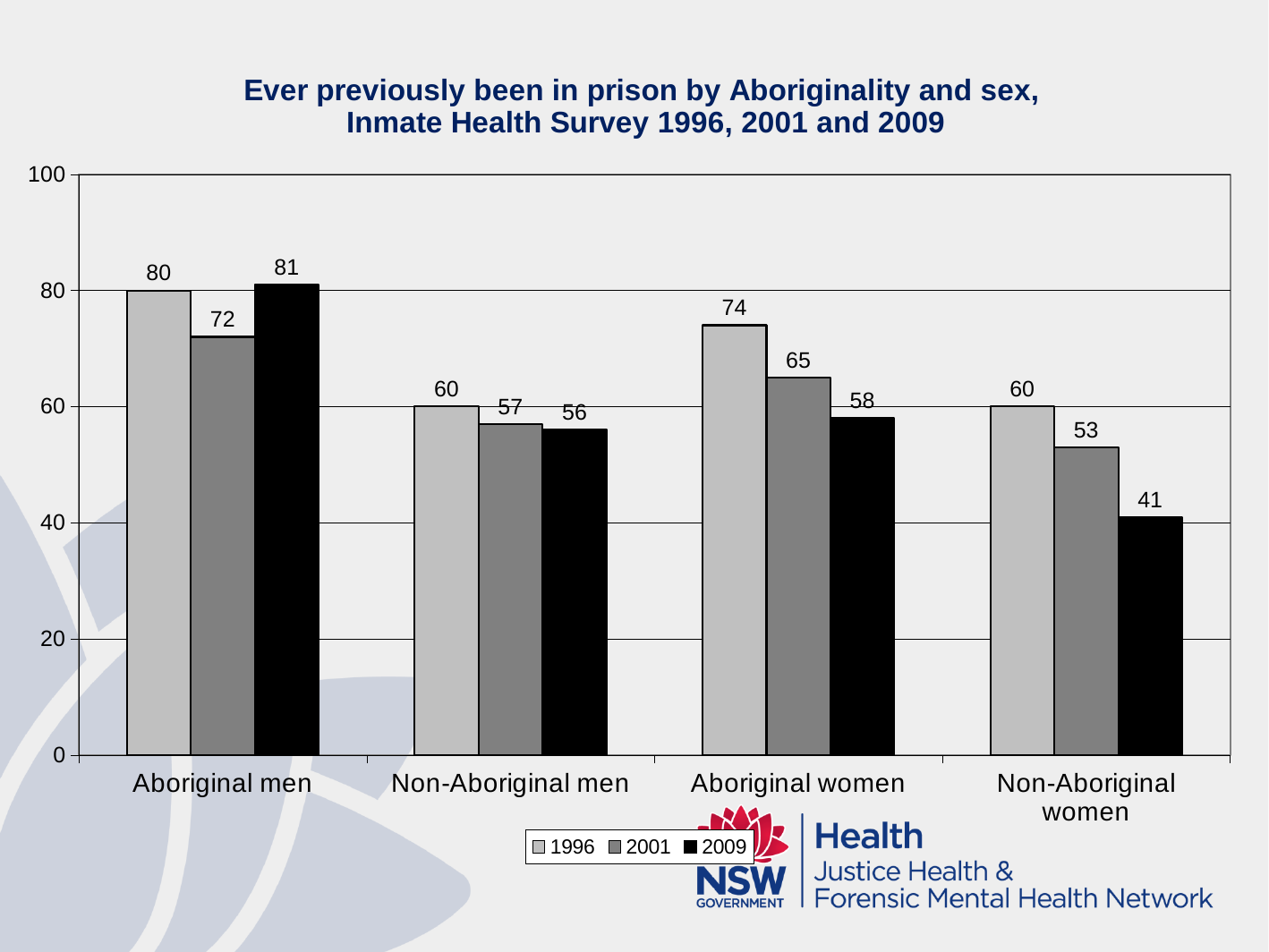
Which category has the highest value in 2009? Aboriginal men What is the value for Aboriginal women in 2001? 65 How many series does the legend list? 3 What is the difference between the 1996 and 2009 values for Non-Aboriginal women? 19 Is the value for Aboriginal women in 1996 greater or less than 60? greater Which is larger: the 2001 value for Aboriginal men or the 2001 value for Aboriginal women? Aboriginal men How many categories are shown on the x axis? 4 What kind of chart is shown on the slide? bar chart Which category has the lowest value in 2009? Non-Aboriginal women What is the value for Aboriginal men in 2009? 81 What is the value for Non-Aboriginal women in 1996? 60 Do the values for Non-Aboriginal women rise or fall from 1996 to 2009? fall